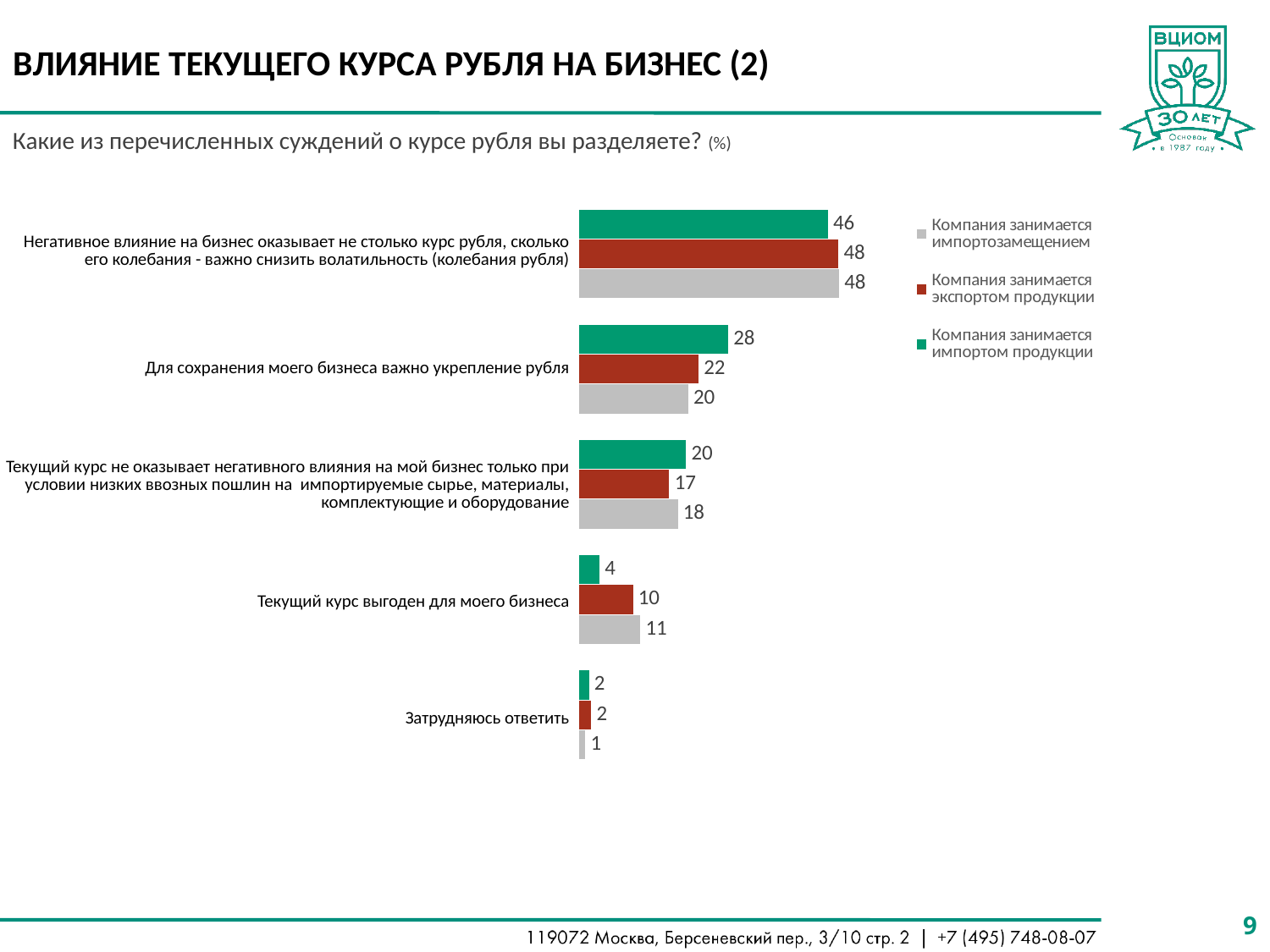
How many series does the legend list? 3 Which statement has the highest value for 'Компания занимается импортом продукции'? Негативное влияние на бизнес оказывает не столько курс рубля, сколько его колебания - важно снизить волатильность (колебания рубля) For 'Для сохранения моего бизнеса важно укрепление рубля', which is larger: the value for 'Компания занимается импортом продукции' or for 'Компания занимается импортозамещением'? Компания занимается импортом продукции What is the difference between the 'Компания занимается экспортом продукции' value and the 'Компания занимается импортом продукции' value for the statement about volatility ('Негативное влияние на бизнес оказывает не столько курс рубля...')? 2 What is the value for 'Компания занимается экспортом продукции' for the statement 'Текущий курс выгоден для моего бизнеса'? 10 What kind of chart is shown on the slide? bar chart What is the difference between the 'Компания занимается импортозамещением' value and the 'Компания занимается импортом продукции' value for 'Текущий курс выгоден для моего бизнеса'? 7 Which statement has the lowest value for 'Компания занимается импортозамещением'? Затрудняюсь ответить How many statement categories are plotted in the chart? 5 What is the value for 'Компания занимается импортом продукции' for the statement 'Для сохранения моего бизнеса важно укрепление рубля'? 28 What is the value for 'Компания занимается импортозамещением' for the statement 'Текущий курс не оказывает негативного влияния на мой бизнес только при условии низких ввозных пошлин...'? 18 Which colour represents the series 'Компания занимается экспортом продукции' in the chart? red